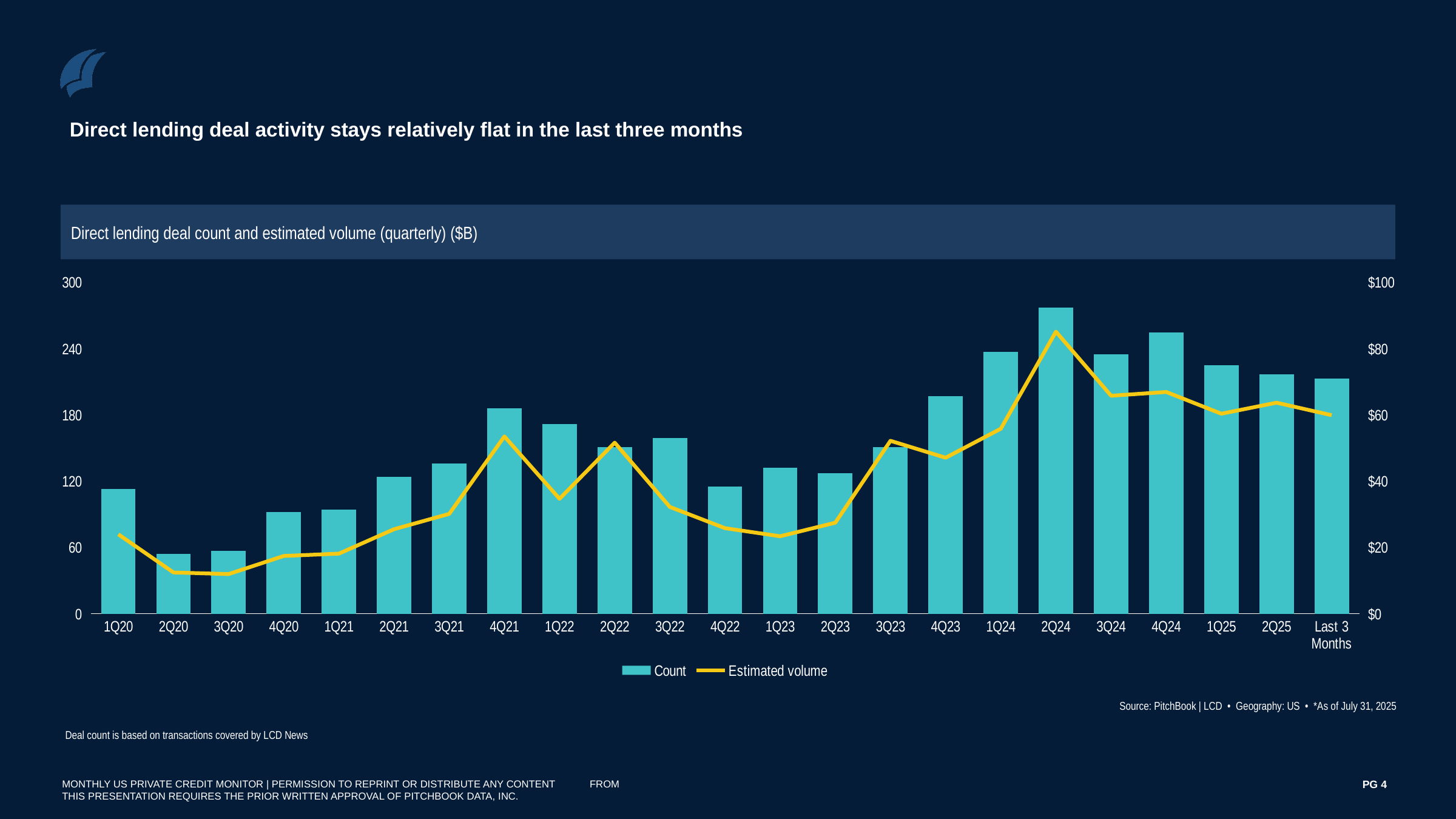
Which quarter has the highest deal count? 2Q24 Is the deal count for 2Q24 greater or less than 240? greater Is the estimated volume for 2Q24 greater or less than $80? greater What kind of chart is shown on the slide? Combination bar and line chart How many categories are shown on the x axis? 23 Is the estimated volume for 1Q23 greater or less than $40? less Which has the larger deal count, 1Q24 or 4Q24? 4Q24 How many series does the legend list? 2 Does the deal count rise or fall from 1Q23 to 2Q24? rise In which quarter does the estimated volume line reach its peak? 2Q24